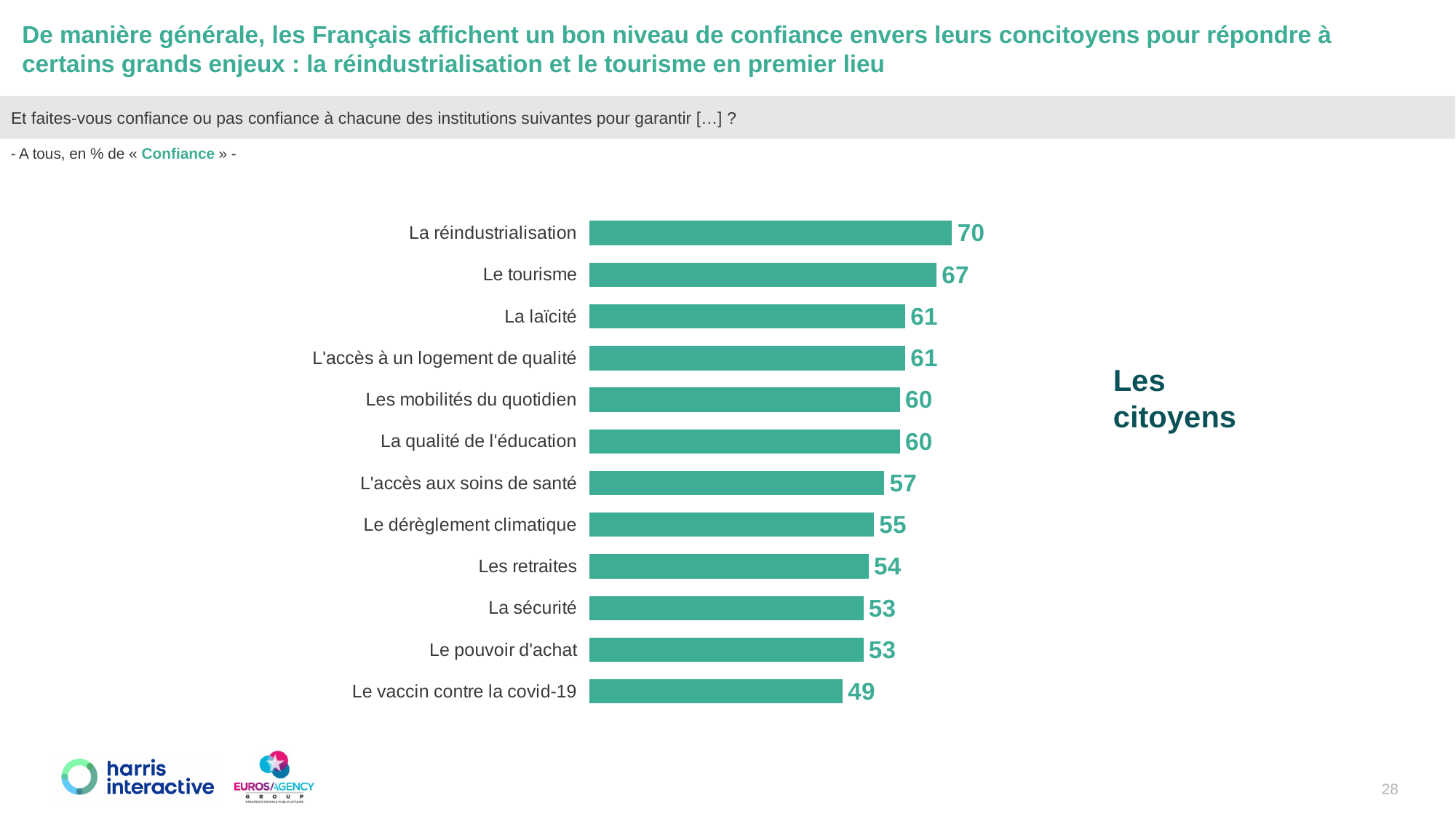
What kind of chart is shown on the slide? Bar chart What is the value for Le dérèglement climatique? 55 What is the value for Le vaccin contre la covid-19? 49 What is the difference between the values for La laïcité and Le vaccin contre la covid-19? 12 What label appears to the right of the chart? Les citoyens Which category has the lowest value? Le vaccin contre la covid-19 What is the value for Les mobilités du quotidien? 60 How many categories are shown in the chart? 12 What is the value for La réindustrialisation? 70 Which category has the highest value? La réindustrialisation Which is larger, the value for L'accès aux soins de santé or the value for Les retraites? L'accès aux soins de santé What is the difference between the values for La réindustrialisation and Le tourisme? 3